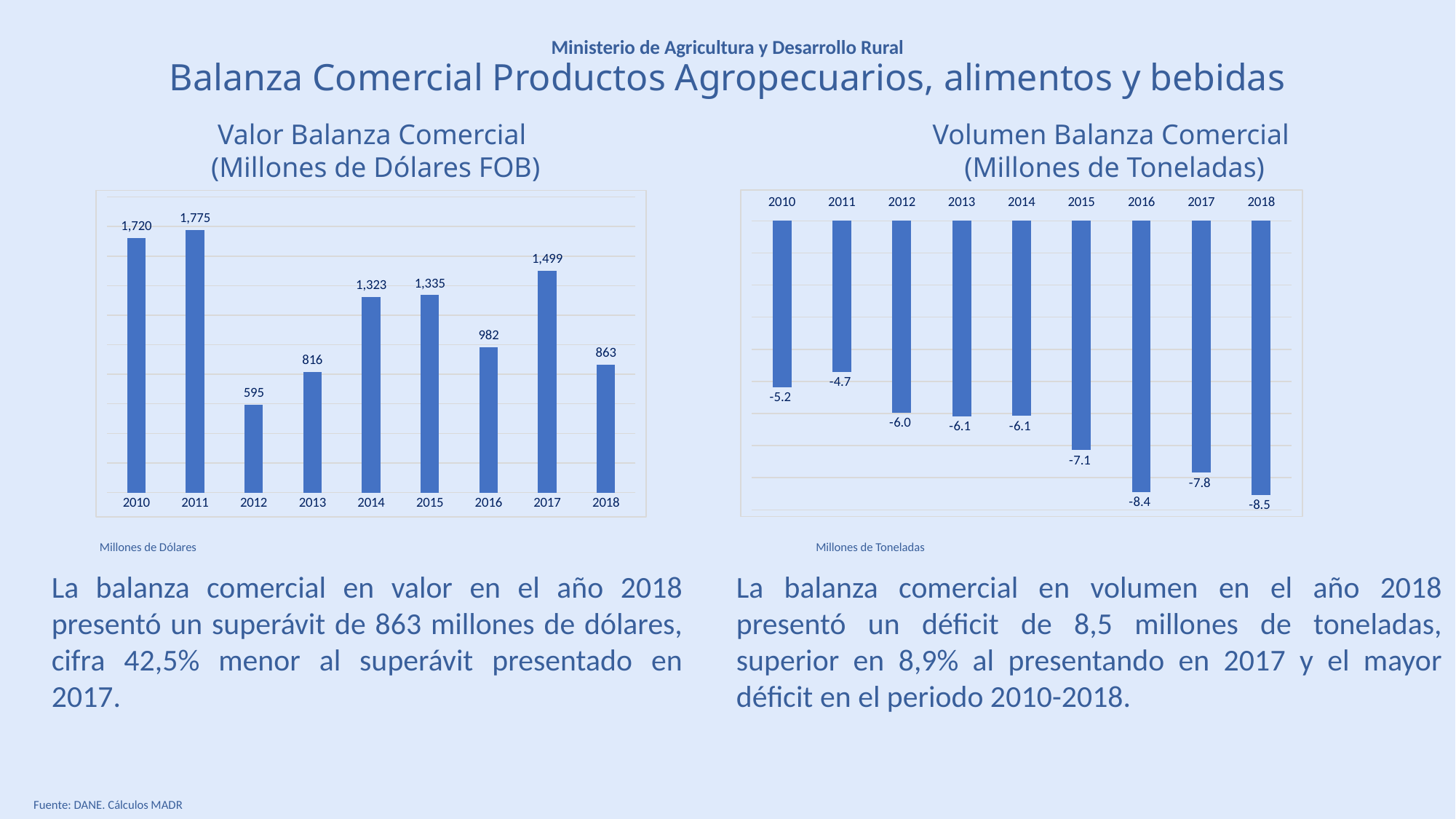
In the 'Valor Balanza Comercial' chart, what is the difference between the values for 2017 and 2018? 636 What kind of chart is the 'Volumen Balanza Comercial' chart? Bar chart In the 'Valor Balanza Comercial' chart, which year has the lowest value? 2012 In the 'Valor Balanza Comercial' chart, which year has the larger value, 2013 or 2016? 2016 In the 'Valor Balanza Comercial' chart, which year has the highest value? 2011 In the 'Volumen Balanza Comercial' chart, do the values generally rise or fall from 2011 to 2018? Fall In the 'Volumen Balanza Comercial' chart, which year has the highest (least negative) value? 2011 In the 'Volumen Balanza Comercial' chart, which year has the lowest (most negative) value? 2018 In the 'Valor Balanza Comercial' chart, what is the value for 2014? 1,323 In the 'Volumen Balanza Comercial' chart, what is the value for 2015? -7.1 In the 'Valor Balanza Comercial' chart, how many years are plotted? 9 In the 'Volumen Balanza Comercial' chart, what is the difference between the values for 2016 and 2017? 0.6